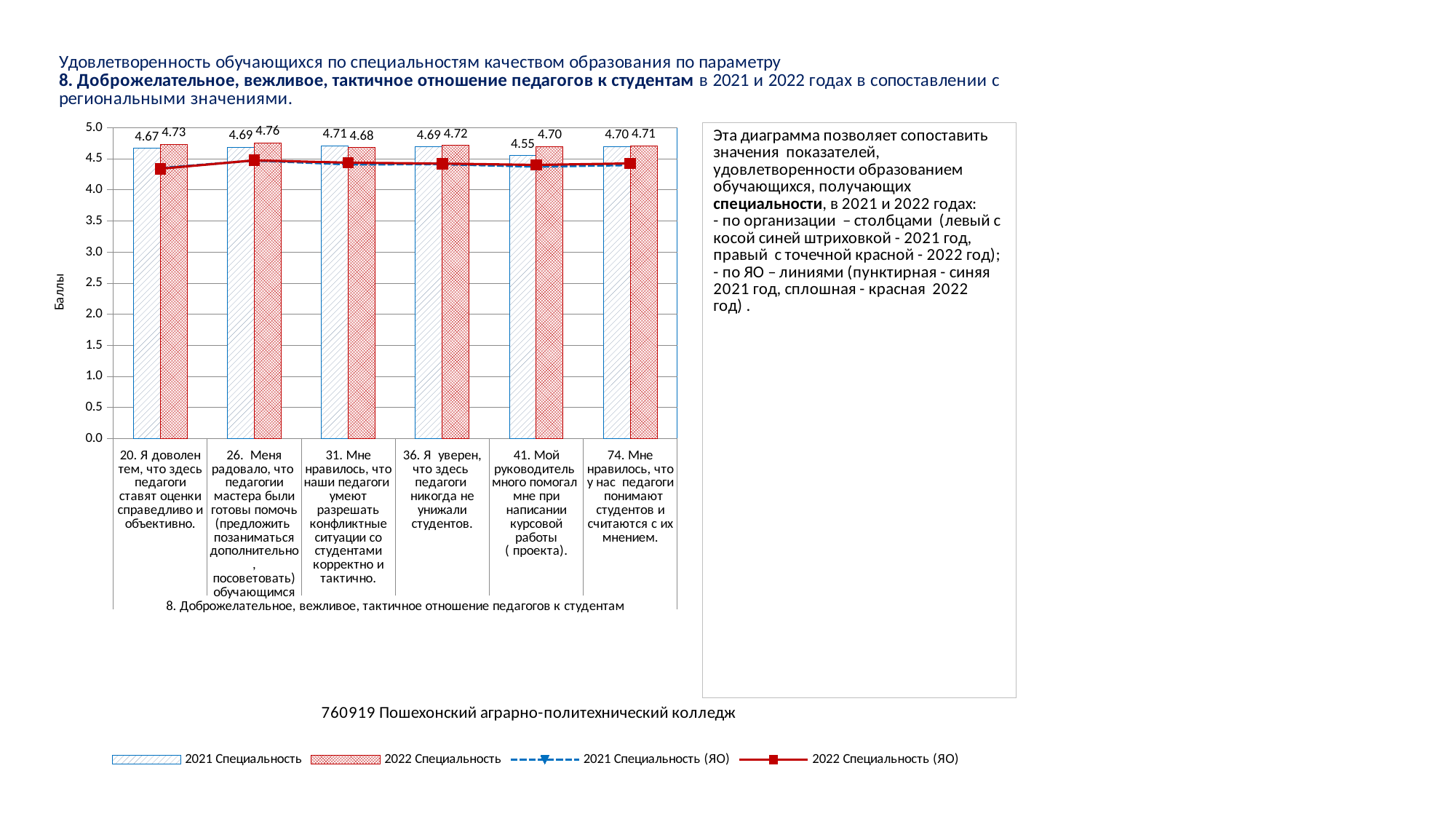
Which item has the lowest 2021 Специальность value? 41. Мой руководитель много помогал мне при написании курсовой работы (проекта). How many series does the chart legend list? 4 What is the 2021 Специальность value for item 20 (Я доволен тем, что здесь педагоги ставят оценки справедливо и объективно)? 4.67 What is the 2021 Специальность value for item 41 (Мой руководитель много помогал мне при написании курсовой работы)? 4.55 How many items (categories) are shown on the x axis of the chart? 6 Is the 2022 Специальность (ЯО) line value for item 20 greater or less than 4.5? less What is the label of the vertical axis of the chart? Баллы Which item has the highest 2022 Специальность value? 26. Меня радовало, что педагоги и мастера были готовы помочь What is the 2022 Специальность value for item 26 (Меня радовало, что педагоги и мастера были готовы помочь)? 4.76 What is the difference between the 2022 and 2021 Специальность values for item 41? 0.15 What is the 2022 Специальность value for item 74 (Мне нравилось, что у нас педагоги понимают студентов и считаются с их мнением)? 4.71 For item 31 (Мне нравилось, что наши педагоги умеют разрешать конфликтные ситуации), which is larger: the 2021 Специальность value or the 2022 Специальность value? 2021 Специальность